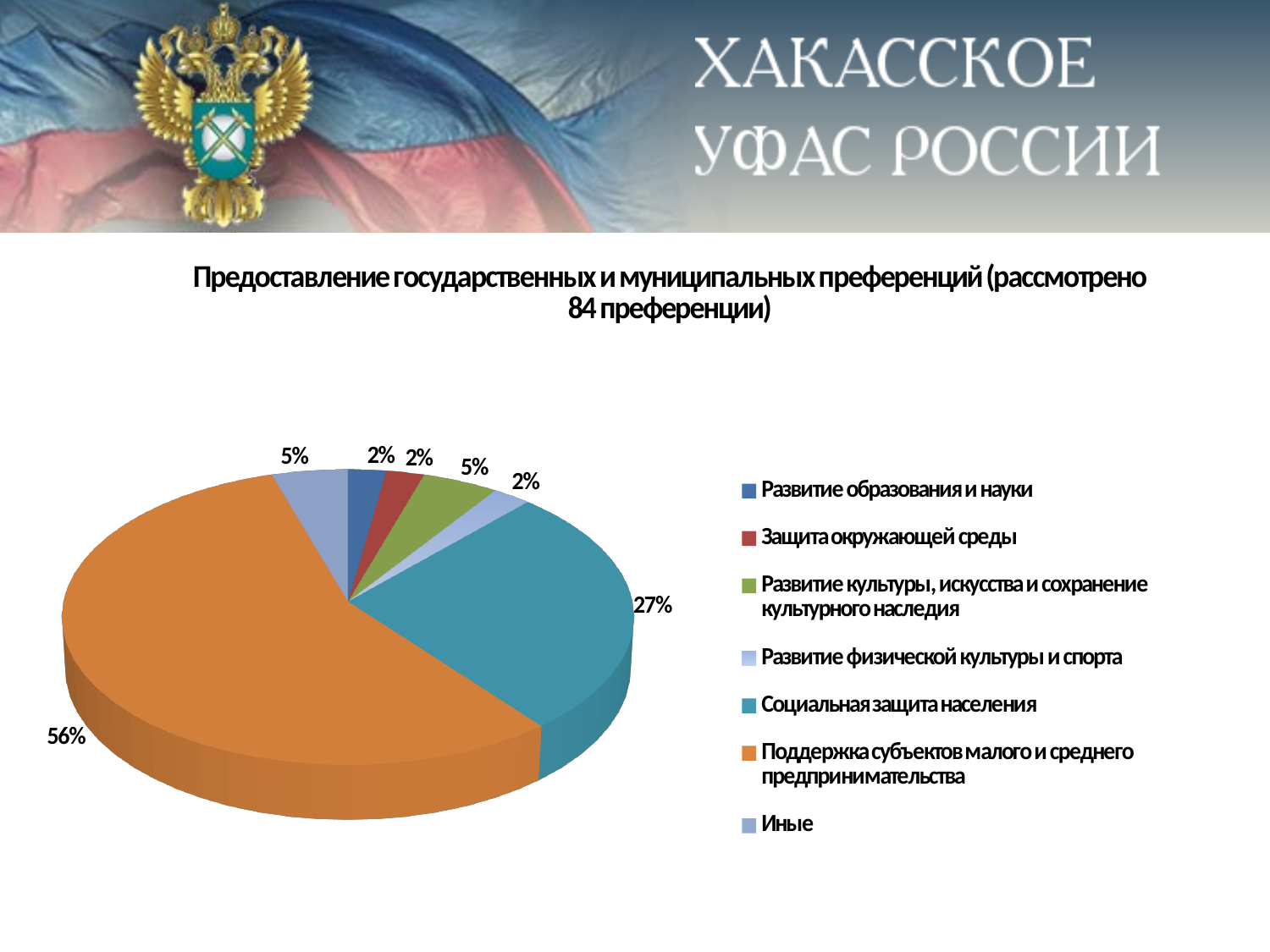
What colour is the slice for 'Социальная защита населения'? teal What share of the pie is 'Иные'? 5% Which category has the largest share of the pie? Поддержка субъектов малого и среднего предпринимательства What kind of chart is shown on the slide? pie chart What is the title of the chart? Предоставление государственных и муниципальных преференций (рассмотрено 84 преференции) What is the difference between the shares for 'Поддержка субъектов малого и среднего предпринимательства' and 'Социальная защита населения'? 29% What share of the pie is 'Развитие образования и науки'? 2% How many categories does the legend list? 7 Which is larger: the share for 'Социальная защита населения' or the share for 'Иные'? Социальная защита населения What share of the pie is 'Социальная защита населения'? 27%